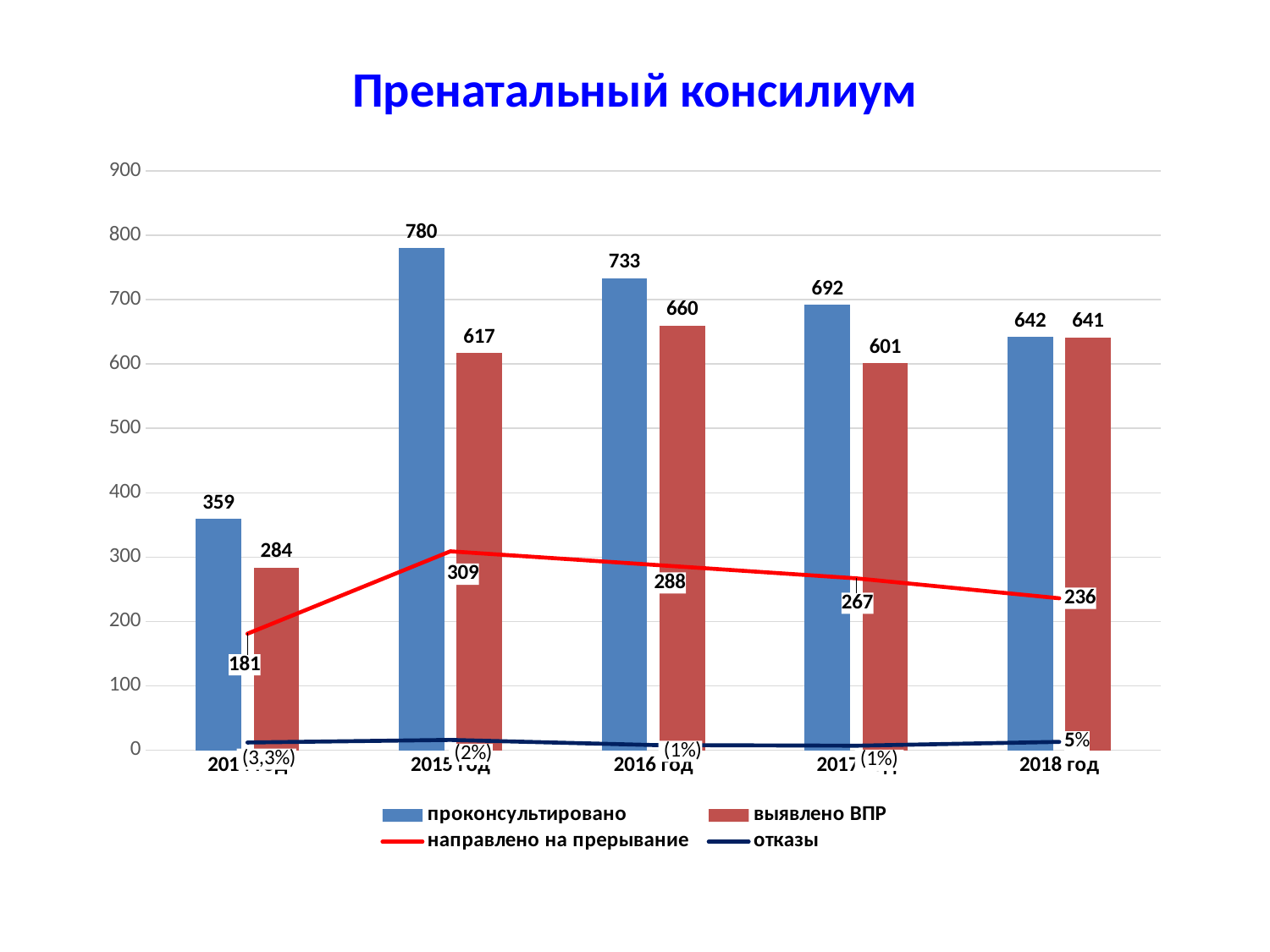
What is the value of проконсультировано for 2015 год? 780 What is the title of the chart? Пренатальный консилиум Does the value of проконсультировано rise or fall from 2015 год to 2018 год? fall Which year has the highest value for проконсультировано? 2015 год How many year categories are shown on the x axis? 5 What is the value of направлено на прерывание for 2017 год? 267 Which year has the highest value for направлено на прерывание? 2015 год What is the difference between проконсультировано and выявлено ВПР in 2018 год? 1 Which is larger: выявлено ВПР in 2016 год or in 2017 год? 2016 год How many series does the legend list? 4 Among 2015 год to 2018 год, which year has the lowest value for выявлено ВПР? 2017 год What is the value of выявлено ВПР for 2016 год? 660